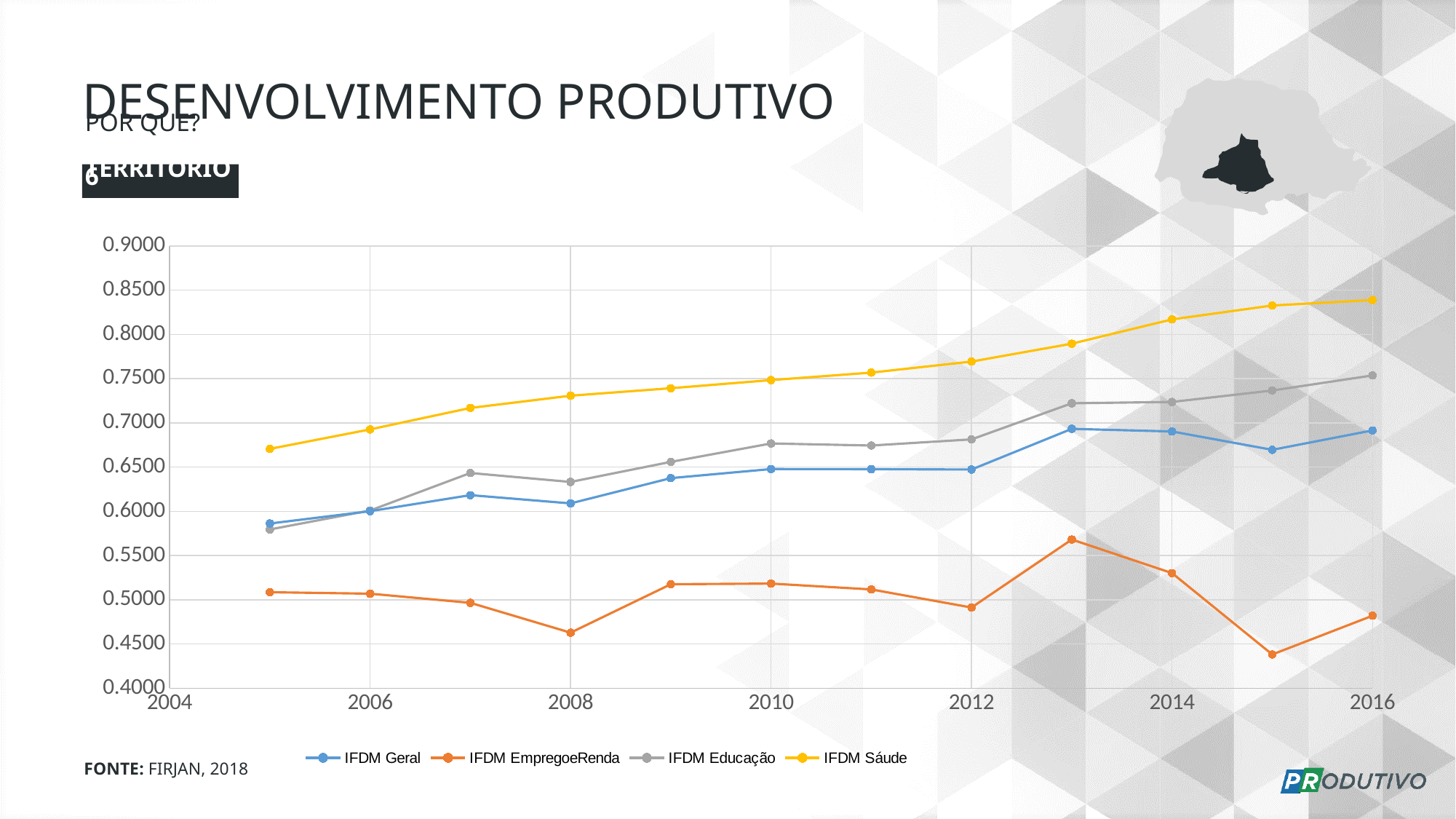
Which series has the lowest value in 2016? IFDM EmpregoeRenda How many series does the legend list? 4 How many data points does the IFDM Saúde line have? 12 In which year is the IFDM EmpregoeRenda value lowest? 2015 Which series has the highest value in 2016? IFDM Saúde In which year is the IFDM EmpregoeRenda value highest? 2013 What colour is the IFDM Saúde line in the legend? Yellow What kind of chart is shown on the slide? Line chart Is the value for IFDM EmpregoeRenda in 2015 greater or less than 0.5000? less Is the value for IFDM Saúde in 2016 greater or less than 0.8000? greater In 2013, which is larger: IFDM Educação or IFDM Geral? IFDM Educação Does the IFDM Saúde line rise or fall from 2005 to 2016? Rises